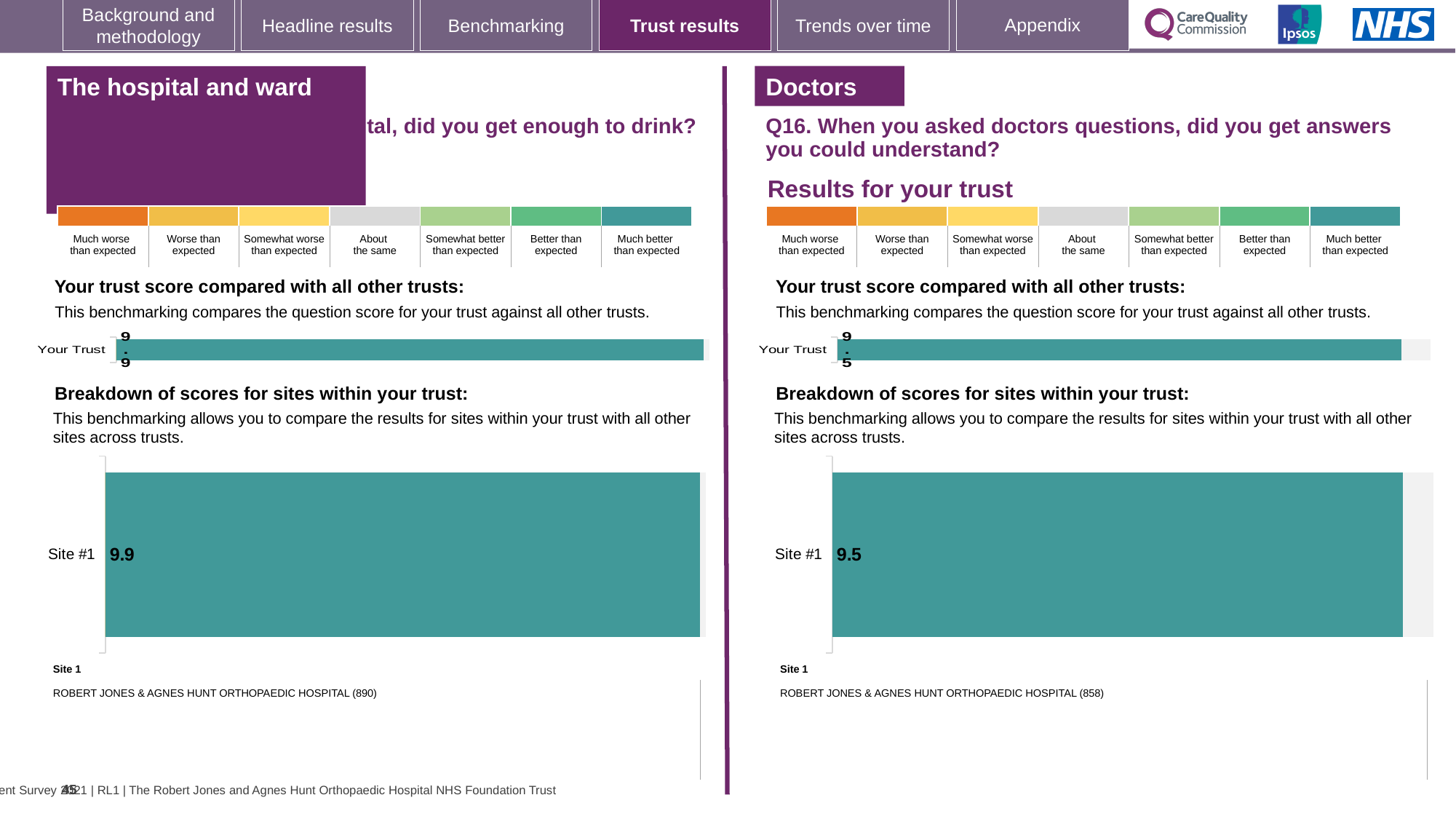
What is the name of the site listed as Site 1 on the right-hand side of the slide? ROBERT JONES & AGNES HUNT ORTHOPAEDIC HOSPITAL (858) What colour are the bars on the 'Your Trust' and 'Site #1' charts? Teal Which is larger: the Site #1 score on the left-hand breakdown chart or the Site #1 score on the right-hand breakdown chart? Left-hand (9.9) On the left-hand 'Breakdown of scores for sites within your trust' chart, what is the value for Site #1? 9.9 On the left-hand 'Your trust score compared with all other trusts' chart, what is the value for Your Trust? 9.9 What kind of chart is used to show the Site #1 score on the right-hand breakdown chart? Bar chart How many sites are shown on the left-hand 'Breakdown of scores for sites within your trust' chart? 1 On the right-hand 'Breakdown of scores for sites within your trust' chart (Q16), what is the value for Site #1? 9.5 On the right-hand 'Your trust score compared with all other trusts' chart (Q16), what is the value for Your Trust? 9.5 What is the difference between the Your Trust score on the left-hand chart (9.9) and the Your Trust score on the right-hand chart (9.5)? 0.4 How many sites are shown on the right-hand 'Breakdown of scores for sites within your trust' chart? 1